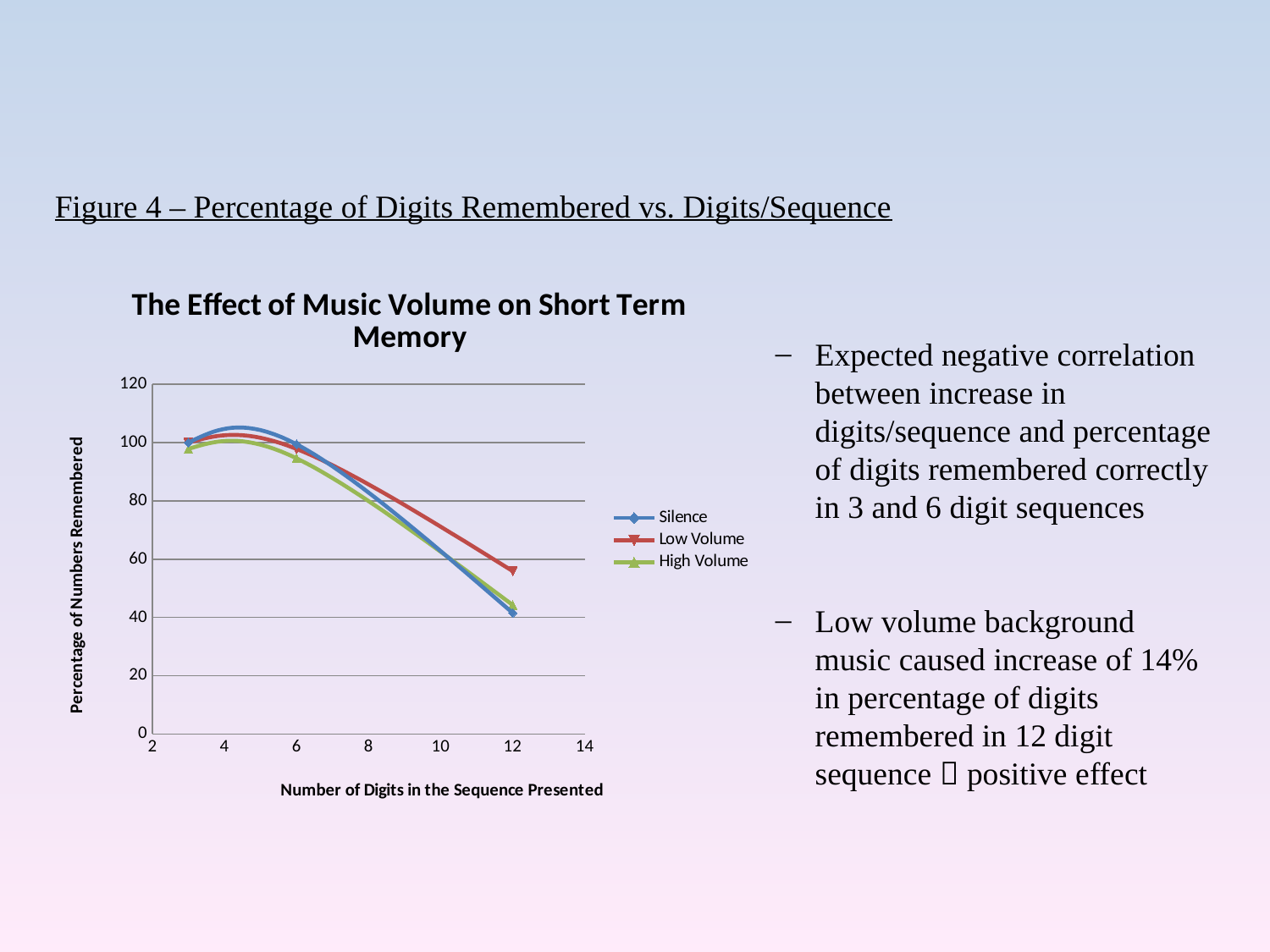
How many series does the chart's legend list? 3 Which series are listed in the chart's legend? Silence, Low Volume, High Volume Is the value for Silence at 12 digits greater or less than 60? less Is the value for High Volume at 6 digits greater or less than 80? greater Do the values for the Silence series rise or fall as the number of digits in the sequence increases from 6 to 12? fall Which series has the highest value at 12 digits in the sequence? Low Volume Is the value for Low Volume at 12 digits greater or less than 80? less How many data points are plotted for the Silence series? 3 What is the title of the chart? The Effect of Music Volume on Short Term Memory At 12 digits in the sequence, is the value for Low Volume or Silence larger? Low Volume What kind of chart is shown on the slide? line chart